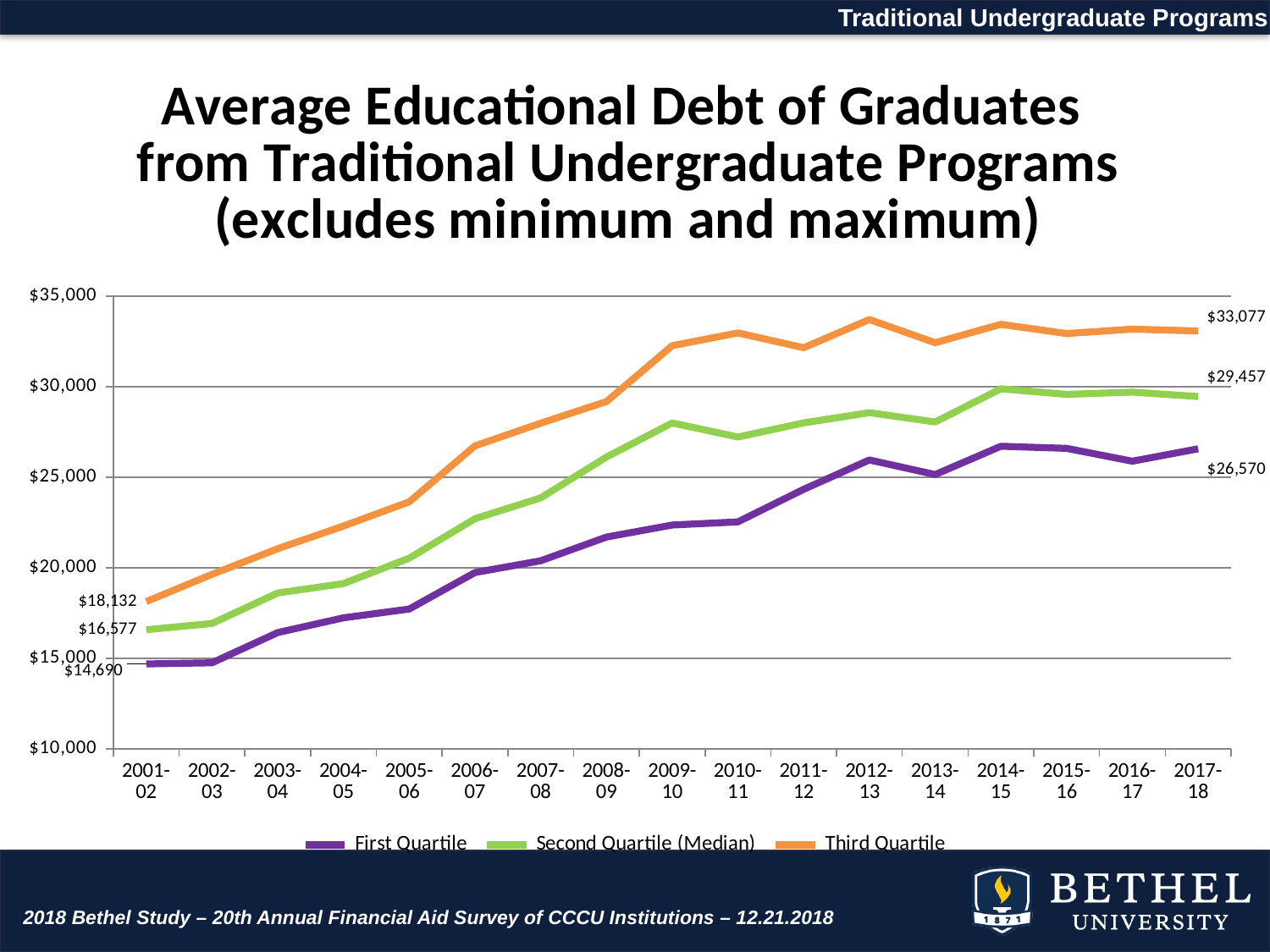
What is the First Quartile value for 2001-02? $14,690 How many academic years are plotted along the x axis? 17 What is the Third Quartile value for 2001-02? $18,132 By how much did the Second Quartile (Median) value increase from 2001-02 to 2017-18? $12,880 How many series does the legend list? 3 What is the difference between the Third Quartile and First Quartile values in 2017-18? $6,507 What is the Third Quartile value for 2017-18? $33,077 Which series has the highest value in 2017-18? Third Quartile What is the Second Quartile (Median) value for 2017-18? $29,457 Overall, do the First Quartile values rise or fall from 2001-02 to 2017-18? rise Is the First Quartile value for 2009-10 greater or less than $20,000? greater What type of chart is shown on the slide? line chart